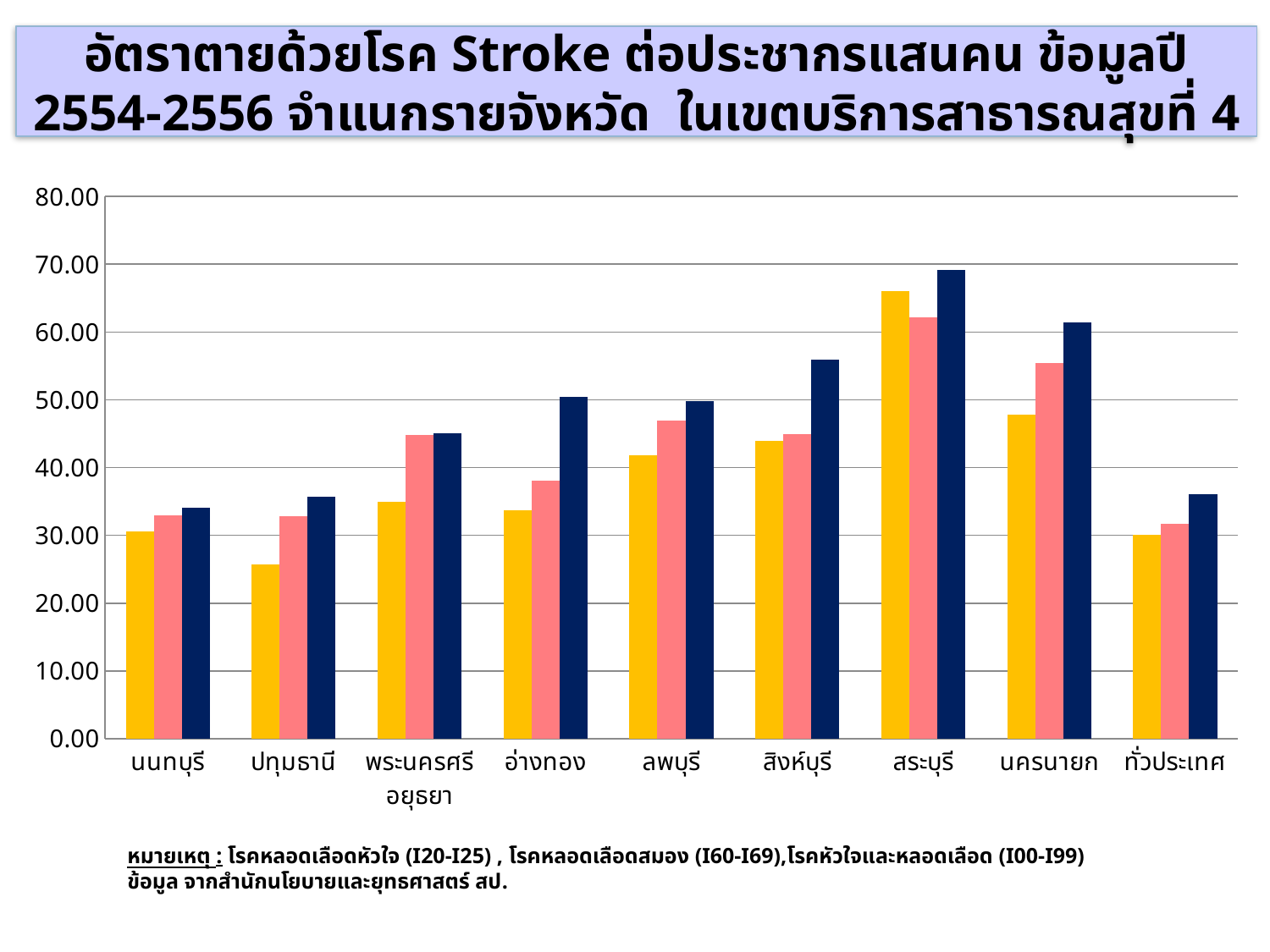
What kind of chart is shown on the slide? bar chart How many categories are shown along the x axis of the chart? 9 Which category has the shortest yellow bar? ปทุมธานี What is the highest value shown on the y axis of the chart? 80.00 Is the value of the dark blue bar for ทั่วประเทศ greater or less than 40.00? less Which category has the tallest dark blue bar? สระบุรี Which has the larger yellow bar, นครนายก or สิงห์บุรี? นครนายก Is the value of the pink bar for อ่างทอง greater or less than 40.00? less Is the value of the yellow bar for ปทุมธานี greater or less than 30.00? less Which has the larger dark blue bar, สิงห์บุรี or ลพบุรี? สิงห์บุรี